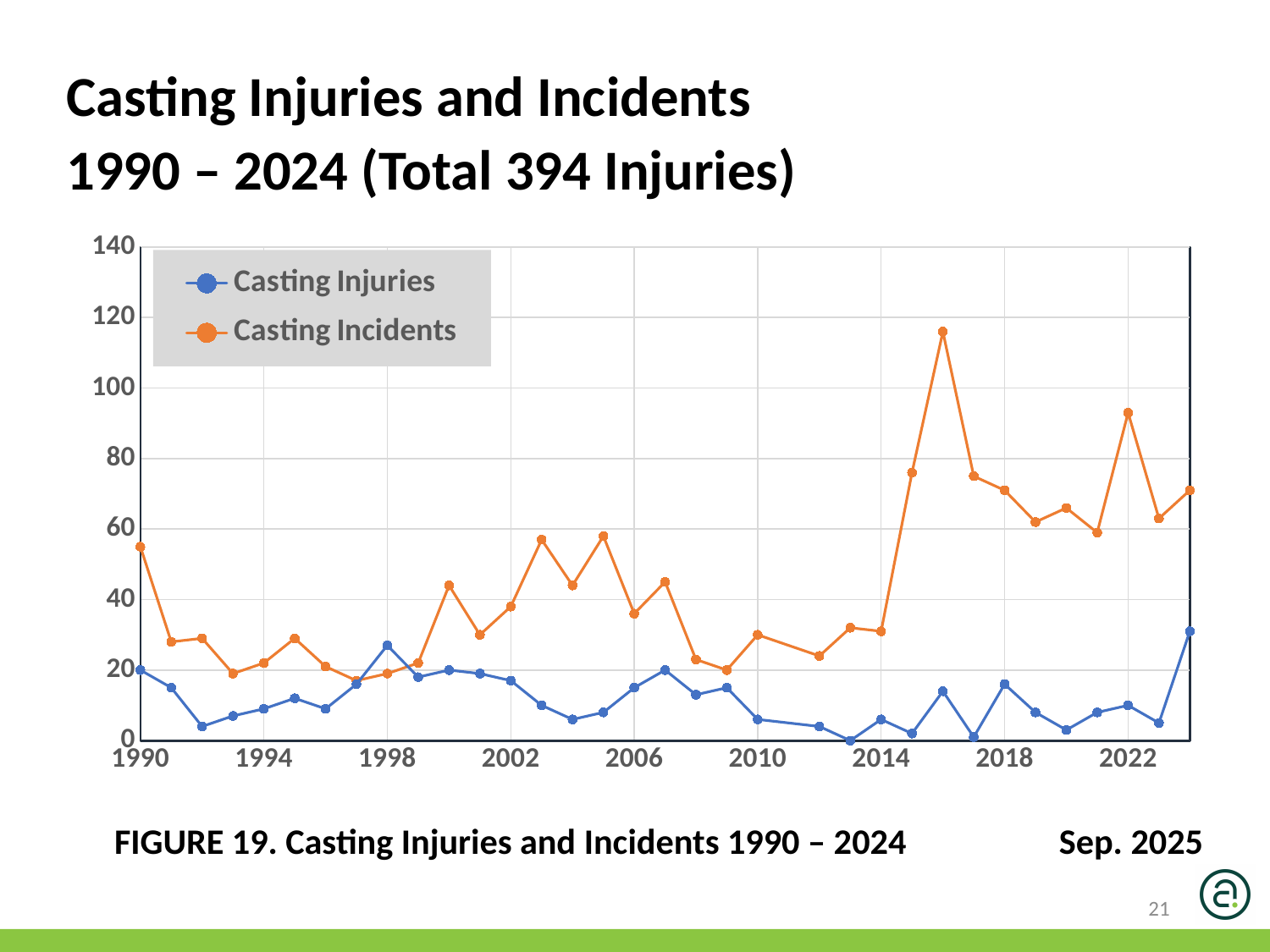
What kind of chart is shown on the slide? line chart How many series does the legend list? 2 In 2016, which series has the larger value, Casting Injuries or Casting Incidents? Casting Incidents Is the value for Casting Injuries in 2024 greater or less than 20? greater What is the figure caption shown below the chart? FIGURE 19. Casting Injuries and Incidents 1990 – 2024 Is the value for Casting Incidents in 1990 greater or less than 40? greater Is the value for Casting Incidents in 2016 greater or less than 100? greater What are the two series named in the legend? Casting Injuries and Casting Incidents Which year has the larger value for Casting Incidents, 2022 or 2023? 2022 Do Casting Incidents rise or fall between 2014 and 2016? rise In which year do Casting Incidents reach their highest value? 2016